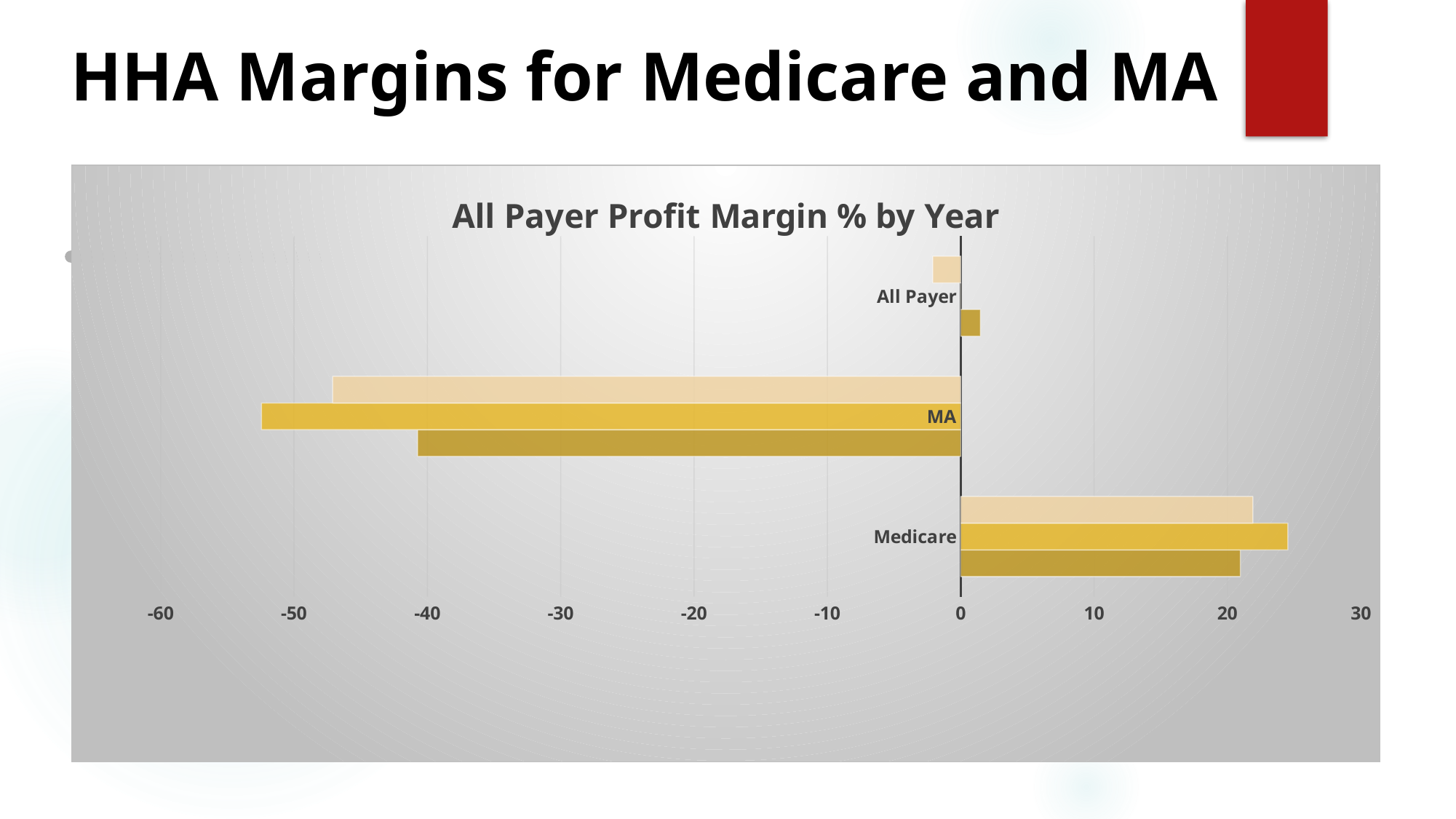
Is the value of the darkest All Payer bar greater or less than 0? greater Which category has the highest profit margin values? Medicare Is the value of the lightest-coloured MA bar greater or less than -40? less Is the value of the longest MA bar greater or less than -50? less Which category has larger values, Medicare or MA? Medicare Which category has the lowest profit margin values? MA What kind of chart is shown on the slide? bar chart How many categories are shown on the chart? 3 What is the title of the chart? All Payer Profit Margin % by Year